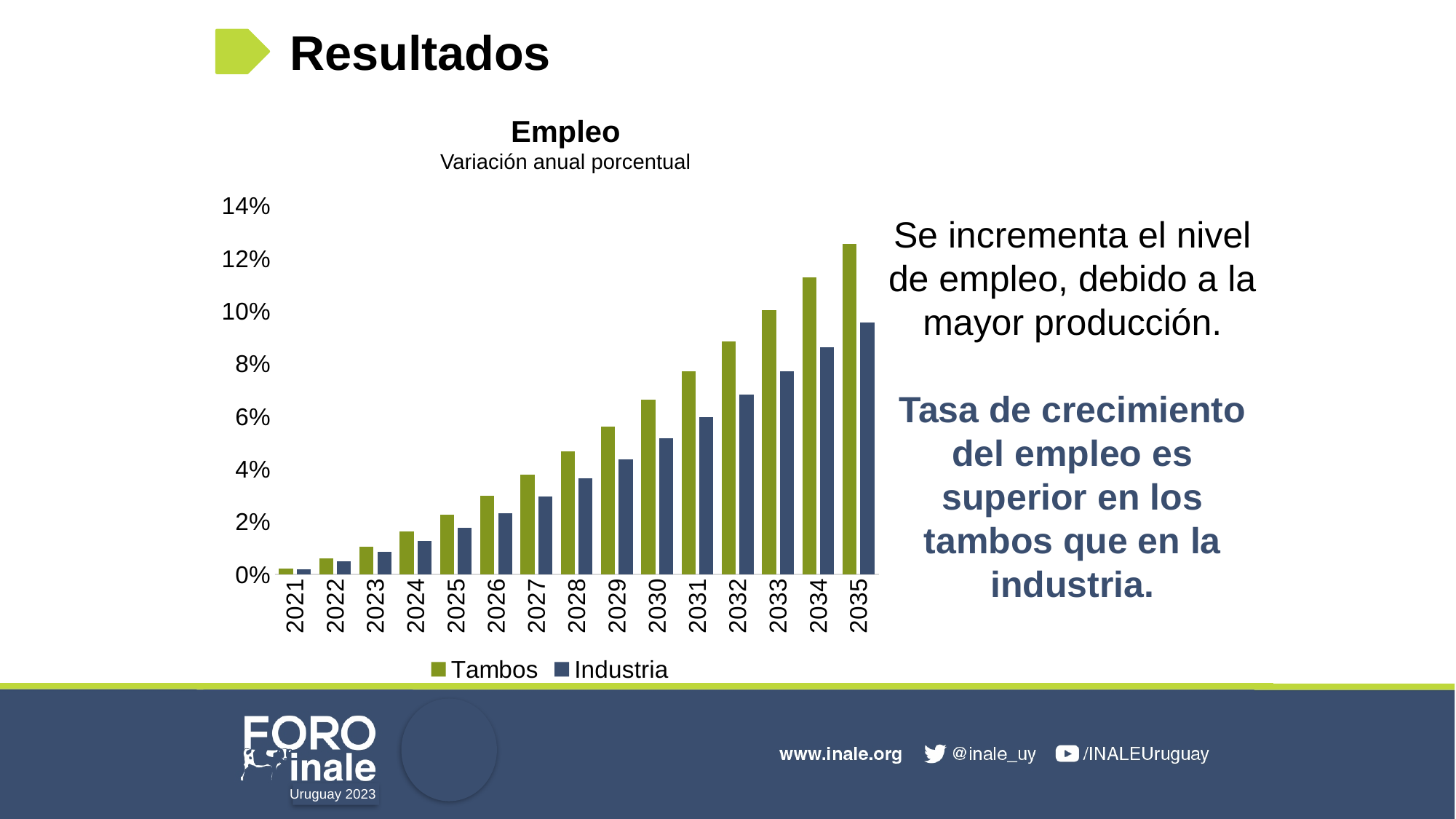
In which year is the Tambos value highest? 2035 Is the Industria value for 2030 greater or less than 4%? greater What is the subtitle shown under the chart title 'Empleo'? Variación anual porcentual What kind of chart is shown on the slide? bar chart Is the Tambos value for 2035 greater or less than 12%? greater How many series does the legend list? 2 In which year is the Industria value lowest? 2021 Which series has the larger value in 2032, Tambos or Industria? Tambos Is the Tambos value for 2034 greater or less than 10%? greater How many years are shown on the x axis? 15 Do the Tambos values rise or fall from 2021 to 2035? rise